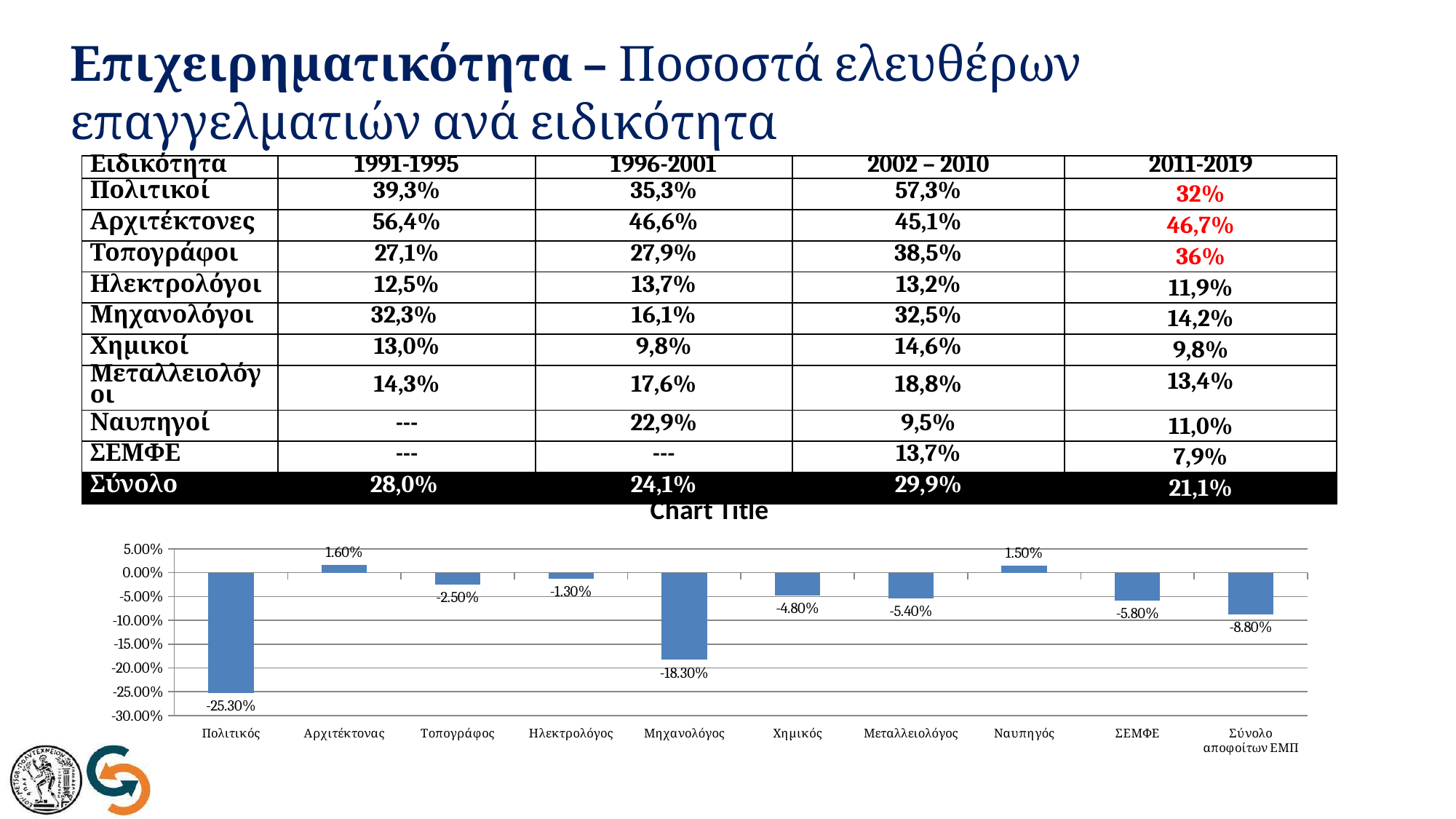
Which category has the lowest value in the chart? Πολιτικός What is the value for Ναυπηγός in the chart? 1.50% What kind of chart is shown on the slide? bar chart What is the title of the chart? Chart Title How many categories are shown on the x axis of the chart? 10 What is the difference between the values for Πολιτικός and Μηχανολόγος in the chart? 7.00% Which has the larger value in the chart, Χημικός or ΣΕΜΦΕ? Χημικός What is the value for Σύνολο αποφοίτων ΕΜΠ in the chart? -8.80% What is the value for Μηχανολόγος in the chart? -18.30% Is the value for Μεταλλειολόγος in the chart greater or less than -10.00%? greater What is the value for Πολιτικός in the chart? -25.30% Which category has the highest value in the chart? Αρχιτέκτονας